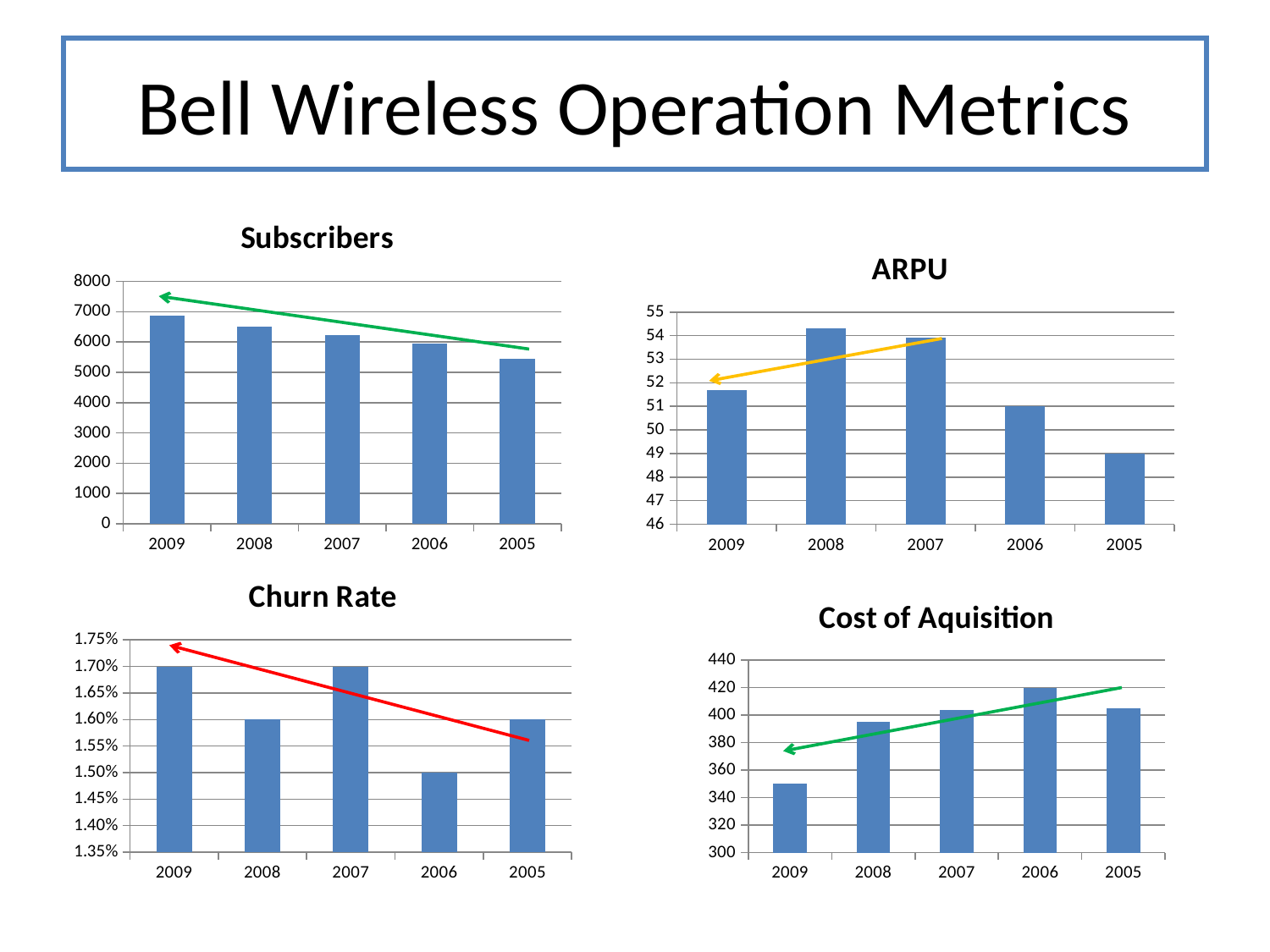
In the Subscribers chart, is the value for 2005 greater or less than 5000? greater In the ARPU chart, what is the value for 2006? 51 In the Cost of Aquisition chart, which year has the highest value? 2006 In the Cost of Aquisition chart, is the value for 2009 greater or less than 360? less In the Churn Rate chart, what is the difference between the values for 2009 and 2008? 0.10% What kind of chart is the Cost of Aquisition chart? bar chart In the Churn Rate chart, what is the value for 2006? 1.50% In the Subscribers chart, how many years are shown on the x axis? 5 In the Subscribers chart, which year has the highest value? 2009 In the ARPU chart, which year has the lowest value? 2005 In the ARPU chart, which is larger, the value for 2008 or the value for 2009? 2008 In the ARPU chart, what is the value for 2005? 49